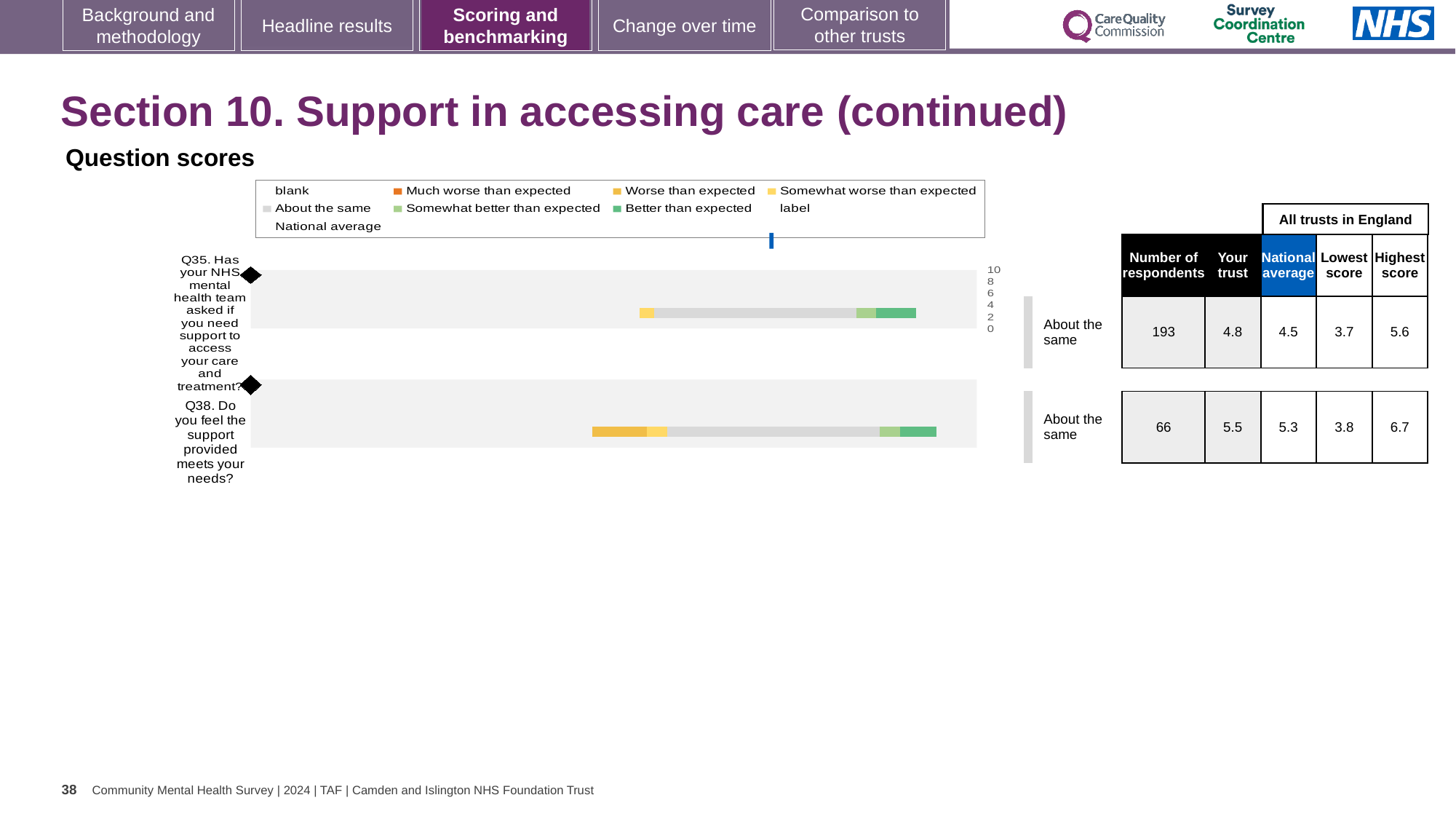
How many respondents answered Q38? 66 What is the national average score for Q35? 4.5 Which question has the higher 'Your trust' score, Q35 or Q38? Q38 What benchmark category is shown next to the bar for Q35? About the same What kind of chart is used to show the question scores on this slide? bar chart What is the difference between the highest score and the lowest score for Q38? 2.9 By how much does the trust's score for Q35 exceed the national average? 0.3 What is the 'Your trust' score for Q35 (Has your NHS mental health team asked if you need support to access your care and treatment)? 4.8 What colour does the legend use for 'Better than expected'? green What is the 'Your trust' score for Q38 (Do you feel the support provided meets your needs)? 5.5 How many questions are plotted in the question scores chart? 2 What is the highest score among all trusts in England for Q35? 5.6